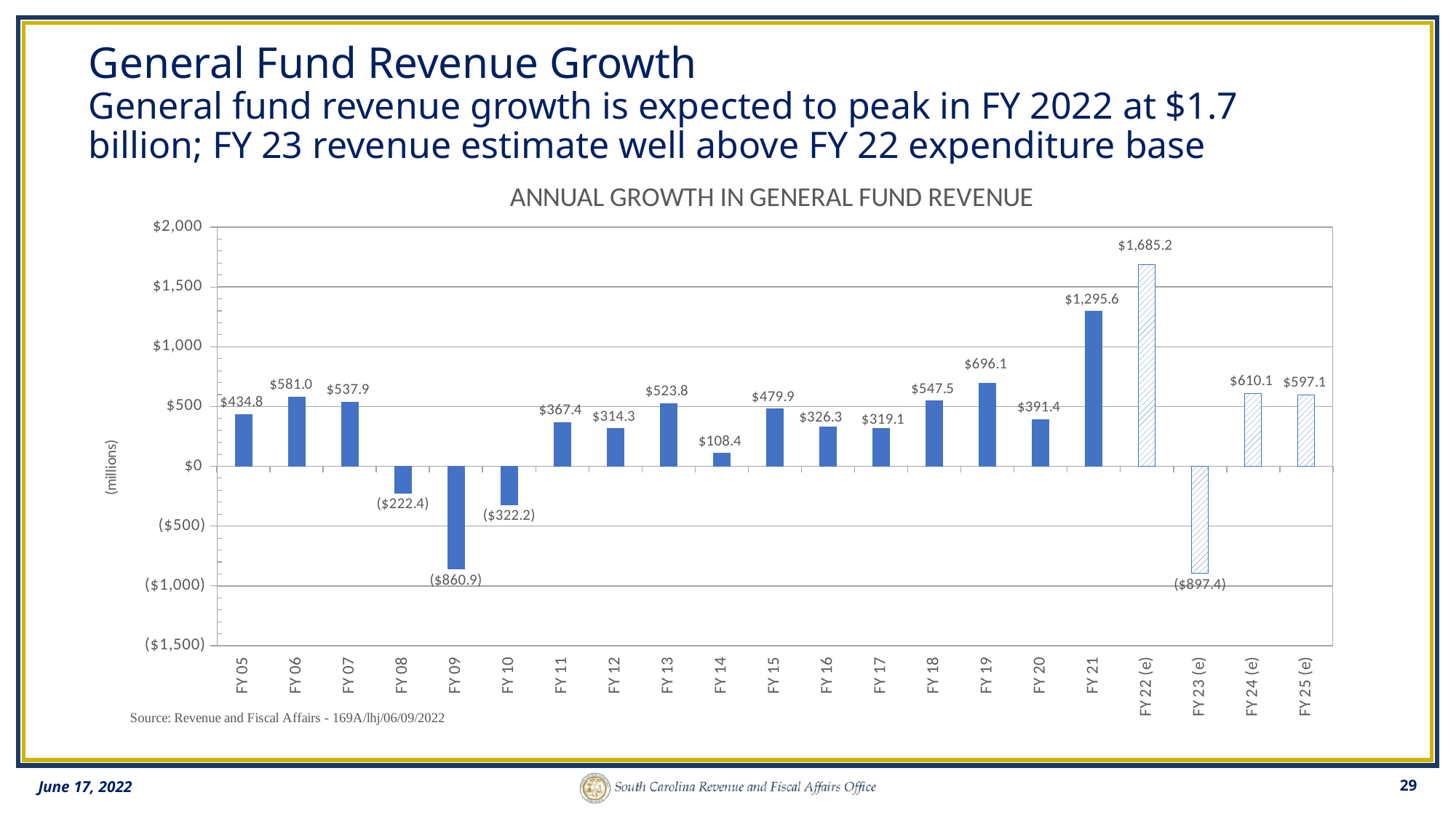
Which is larger, the value for FY 06 or the value for FY 07? FY 06 What is the value for FY 14? $108.4 What kind of chart is shown on the slide? Bar chart What is the value for FY 23 (e)? ($897.4) How many fiscal years are shown on the x axis? 21 What is the value for FY 09? ($860.9) What is the difference between the values for FY 22 (e) and FY 21? $389.6 Which fiscal year has the lowest annual growth in general fund revenue? FY 23 (e) Which fiscal year has the highest annual growth in general fund revenue? FY 22 (e) What is the difference between the values for FY 19 and FY 18? $148.6 What is the title of the chart? ANNUAL GROWTH IN GENERAL FUND REVENUE What is the value for FY 21? $1,295.6